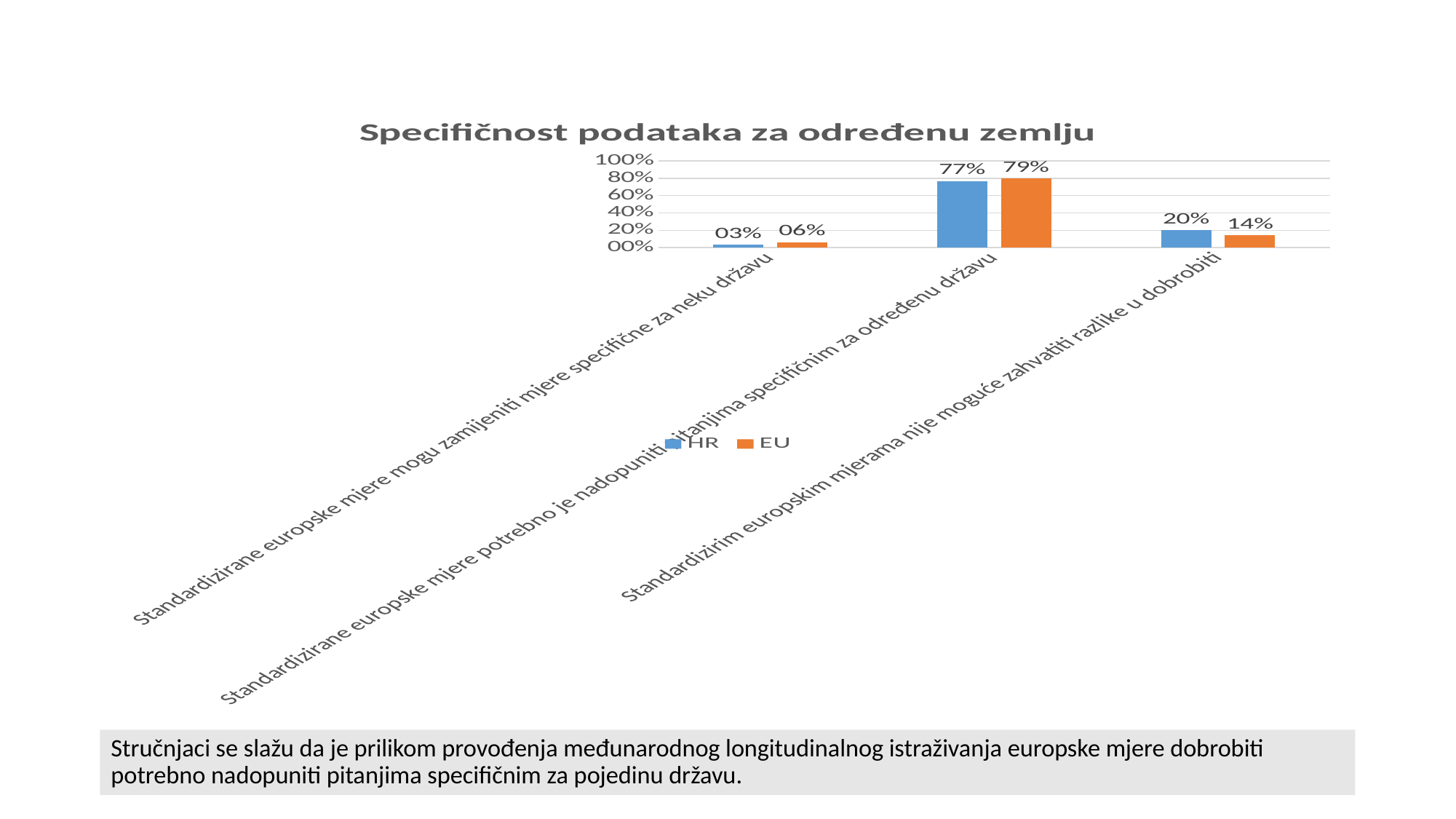
What is the HR value for "Standardizirane europske mjere potrebno je nadopuniti pitanjima specifičnim za određenu državu"? 77% How many categories are shown on the x axis? 3 Which category has the highest EU value? Standardizirane europske mjere potrebno je nadopuniti pitanjima specifičnim za određenu državu What is the HR value for "Standardizirim europskim mjerama nije moguće zahvatiti razlike u dobrobiti"? 20% What type of chart is shown on the slide? bar chart What is the EU value for "Standardizirane europske mjere mogu zamijeniti mjere specifične za neku državu"? 06% How many series does the legend list? 2 For "Standardizirim europskim mjerama nije moguće zahvatiti razlike u dobrobiti", which is larger, HR or EU? HR Is the HR value for "Standardizirane europske mjere potrebno je nadopuniti pitanjima specifičnim za određenu državu" greater or less than 60%? greater Which category has the lowest HR value? Standardizirane europske mjere mogu zamijeniti mjere specifične za neku državu What is the difference between the HR and EU values for "Standardizirim europskim mjerama nije moguće zahvatiti razlike u dobrobiti"? 6% What is the EU value for "Standardizirane europske mjere potrebno je nadopuniti pitanjima specifičnim za određenu državu"? 79%